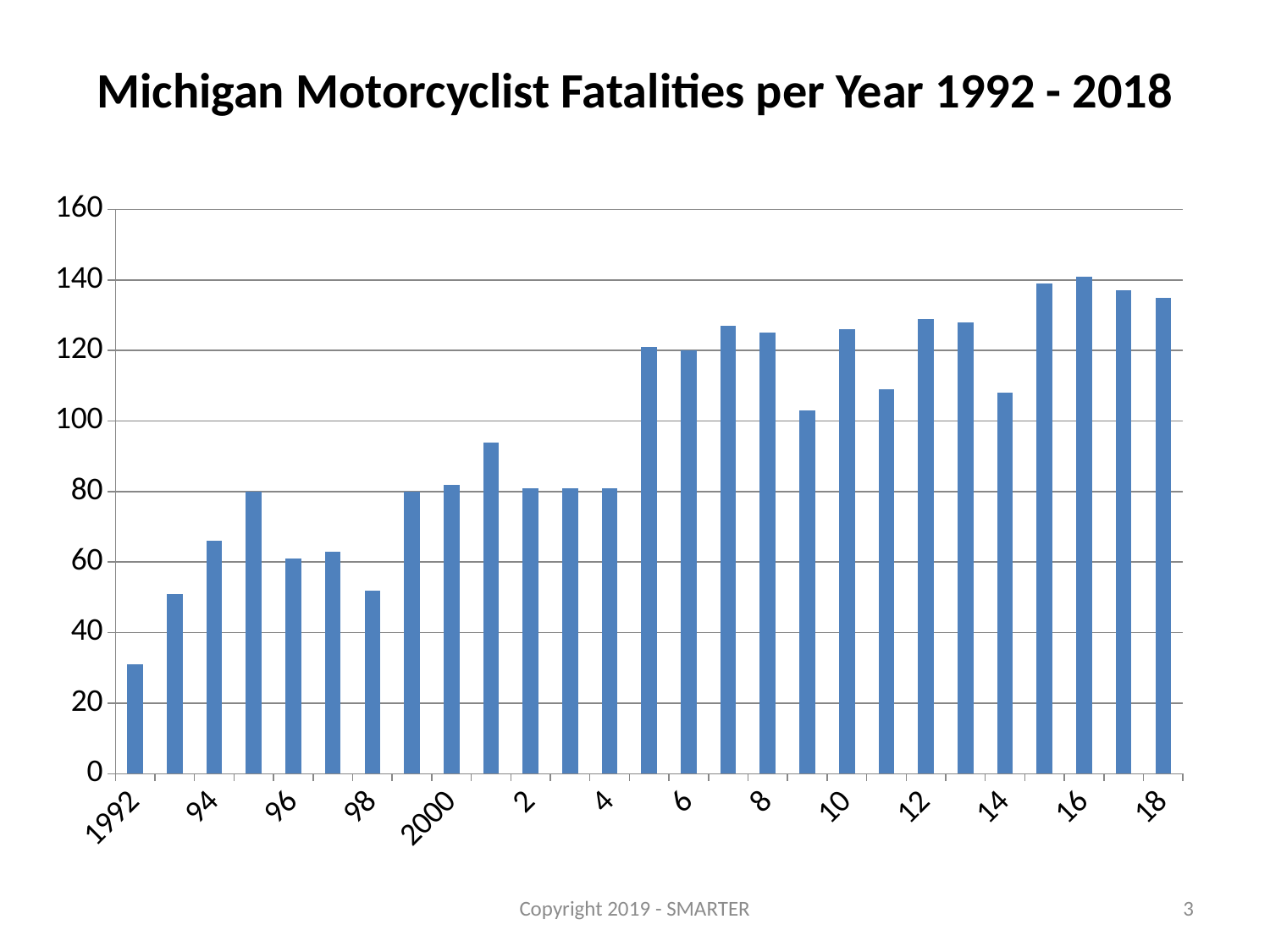
Overall, do motorcyclist fatalities rise or fall from 1992 to 2018? rise What kind of chart is shown on the slide? bar chart Which year has the highest number of motorcyclist fatalities? 2016 Which year has the lowest number of motorcyclist fatalities? 1992 Is the value for 1998 greater or less than 60? less Is the value for 1992 greater or less than 40? less What is the title of the chart? Michigan Motorcyclist Fatalities per Year 1992 - 2018 Which year has more fatalities, 2009 or 2010? 2010 Is the value for 2001 greater or less than 80? greater Which year has more fatalities, 2000 or 2001? 2001 How many years (bars) are plotted in the chart? 27